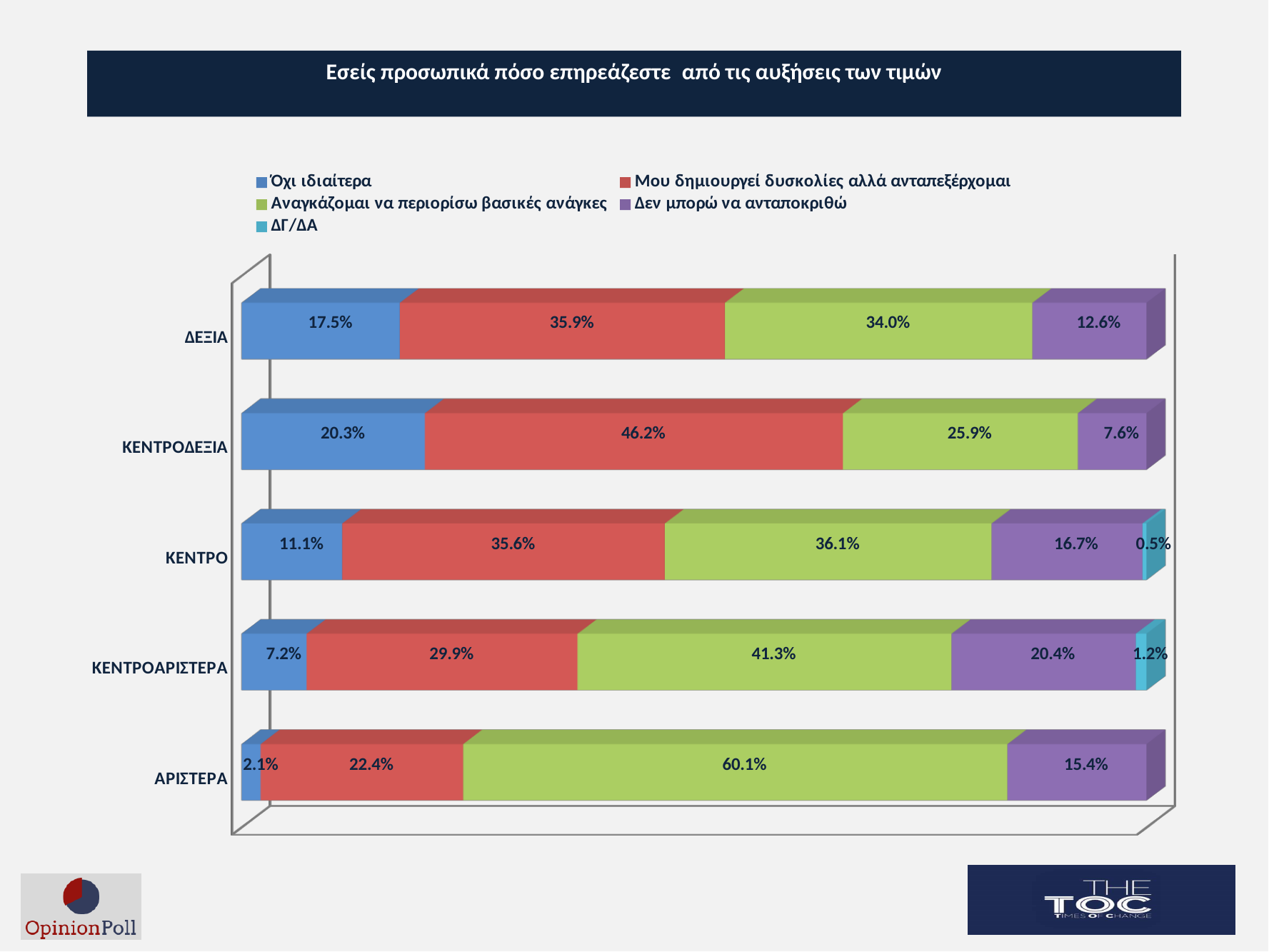
Which category has the highest value for 'Δεν μπορώ να ανταποκριθώ'? ΚΕΝΤΡΟΑΡΙΣΤΕΡΑ Which is larger: the 'Όχι ιδιαίτερα' value for ΚΕΝΤΡΟΔΕΞΙΑ or for ΚΕΝΤΡΟ? ΚΕΝΤΡΟΔΕΞΙΑ What is the difference in percentage points between the 'Αναγκάζομαι να περιορίσω βασικές ανάγκες' values for ΑΡΙΣΤΕΡΑ and ΔΕΞΙΑ? 26.1 What percentage of ΔΕΞΙΑ respondents answered 'Όχι ιδιαίτερα'? 17.5% Which category has the lowest value for 'Όχι ιδιαίτερα'? ΑΡΙΣΤΕΡΑ How many categories (political positions) are shown on the chart? 5 Which category has the highest value for 'Μου δημιουργεί δυσκολίες αλλά ανταπεξέρχομαι'? ΚΕΝΤΡΟΔΕΞΙΑ What is the total of the printed values in the ΚΕΝΤΡΟ bar? 100.0% How many series does the legend list? 5 What is the 'ΔΓ/ΔΑ' value for ΚΕΝΤΡΟΑΡΙΣΤΕΡΑ? 1.2% What kind of chart is shown on the slide? Stacked bar chart What is the value for 'Αναγκάζομαι να περιορίσω βασικές ανάγκες' in the ΑΡΙΣΤΕΡΑ bar? 60.1%